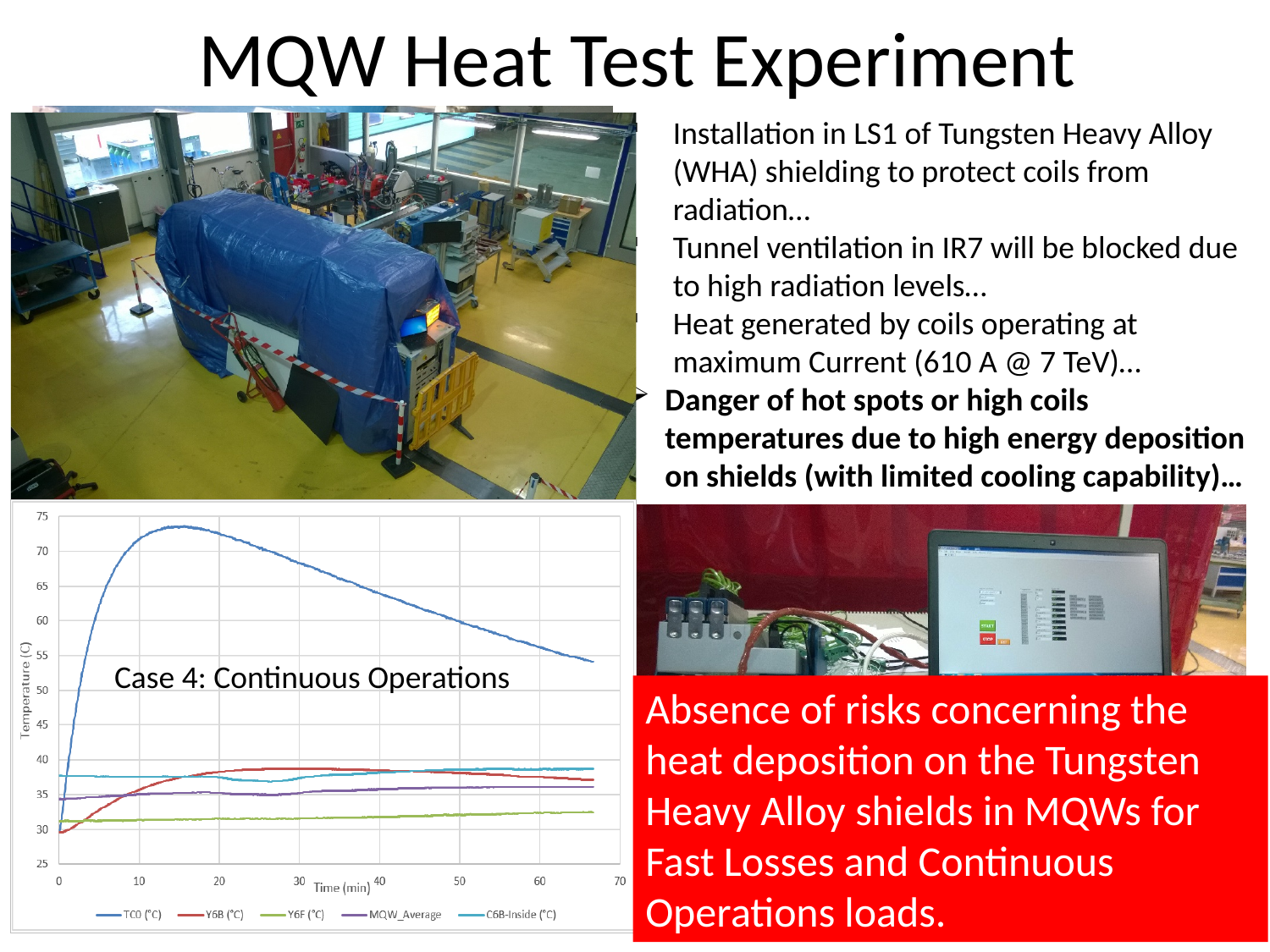
Which series reaches the highest temperature on the chart? TC0 (°C) What is the label of the x axis of the chart? Time (min) Is the value of the MQW_Average series at 40 minutes greater or less than 40? less What case is the chart labelled as showing? Case 4: Continuous Operations How many series does the chart legend list? 5 Which is larger at 20 minutes: the TC0 (°C) value or the Y6B (°C) value? TC0 (°C) Is the value of the TC0 (°C) series at 60 minutes greater or less than 55? greater Which series stays lowest on the chart throughout the test? Y6F (°C) What kind of chart is shown on the slide? line chart Is the peak value of the TC0 (°C) series greater or less than 70? greater How does the TC0 (°C) series change over time after about 15 minutes? it falls